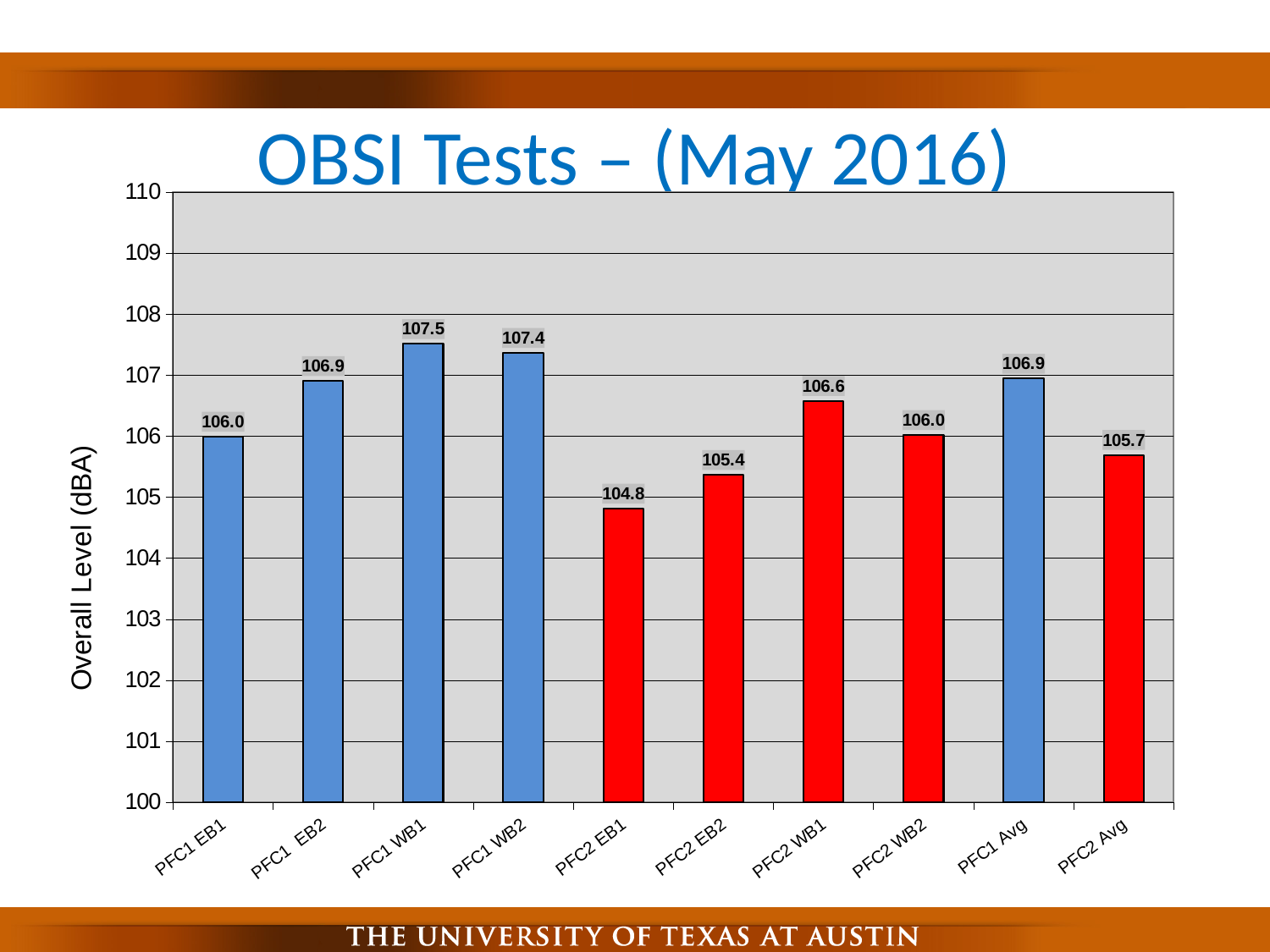
Is the value for PFC2 WB1 greater or less than 107? less Which is larger, PFC1 EB2 or PFC2 WB1? PFC1 EB2 Which category has the lowest value? PFC2 EB1 What is the difference between PFC1 WB1 and PFC2 EB1? 2.7 What is the value for PFC1 WB1? 107.5 What is the value for PFC2 EB2? 105.4 What is the y-axis label of the chart? Overall Level (dBA) How many categories are shown on the x axis? 10 What is the difference between PFC1 Avg and PFC2 Avg? 1.2 What is the value for PFC2 Avg? 105.7 What kind of chart is shown? bar chart Which category has the highest value? PFC1 WB1